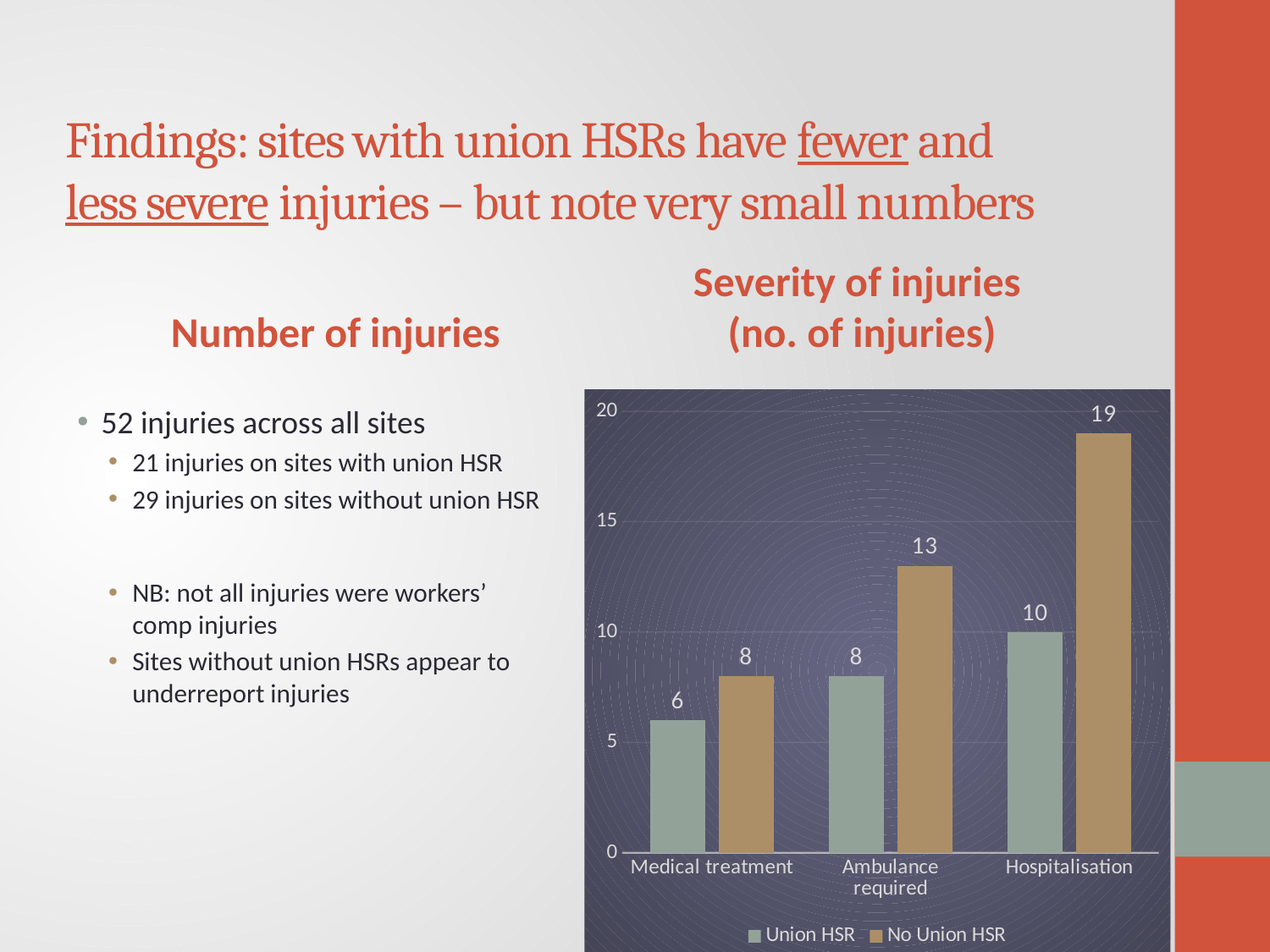
Which category has the highest value for No Union HSR? Hospitalisation What is the value for No Union HSR in the Hospitalisation category? 19 How many categories are shown on the x axis of the chart? 3 What kind of chart is shown on the slide? Bar chart What is the value for No Union HSR in the Ambulance required category? 13 What is the value for Union HSR in the Hospitalisation category? 10 What is the difference between No Union HSR and Union HSR in the Hospitalisation category? 9 What is the value for Union HSR in the Medical treatment category? 6 Which category has the lowest value for Union HSR? Medical treatment Do the No Union HSR values rise or fall from Medical treatment to Hospitalisation? Rise How many series does the chart legend list? 2 Which is larger in the Ambulance required category, Union HSR or No Union HSR? No Union HSR